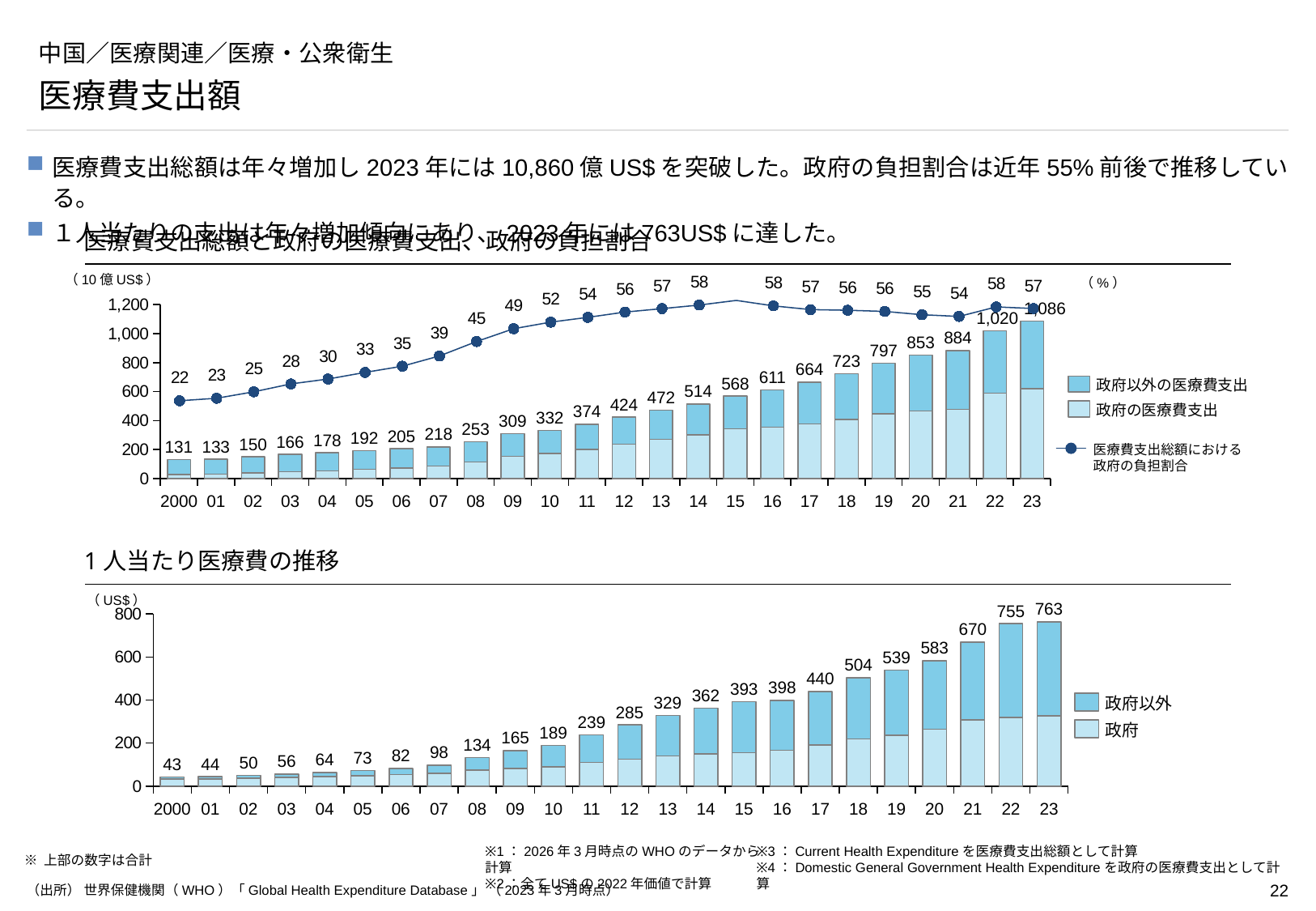
In the top chart, how many series does the legend list? 3 What kind of chart is the bottom chart (1人当たり医療費の推移)? Stacked bar chart In the bottom chart (1人当たり医療費の推移), how many years are plotted? 24 In the top chart, which year has the highest total health expenditure? 23 (2023) In the top chart, what is the government share (%) shown for 2000? 22 In the bottom chart (1人当たり医療費の推移), what is the difference between the 2022 and 2021 values? 85 In the bottom chart (1人当たり医療費の推移), which year has the lowest per-capita value? 2000 In the bottom chart (1人当たり医療費の推移), what is the per-capita value for 2023? 763 In the top chart, is the government share higher in 2014 or in 2021? 2014 In the top chart, what is the difference between the total for 2023 and the total for 2022? 66 In the top chart, what is the total health expenditure for 2023? 1,086 In the bottom chart (1人当たり医療費の推移), is the 政府 portion for 2023 greater or less than 200? greater